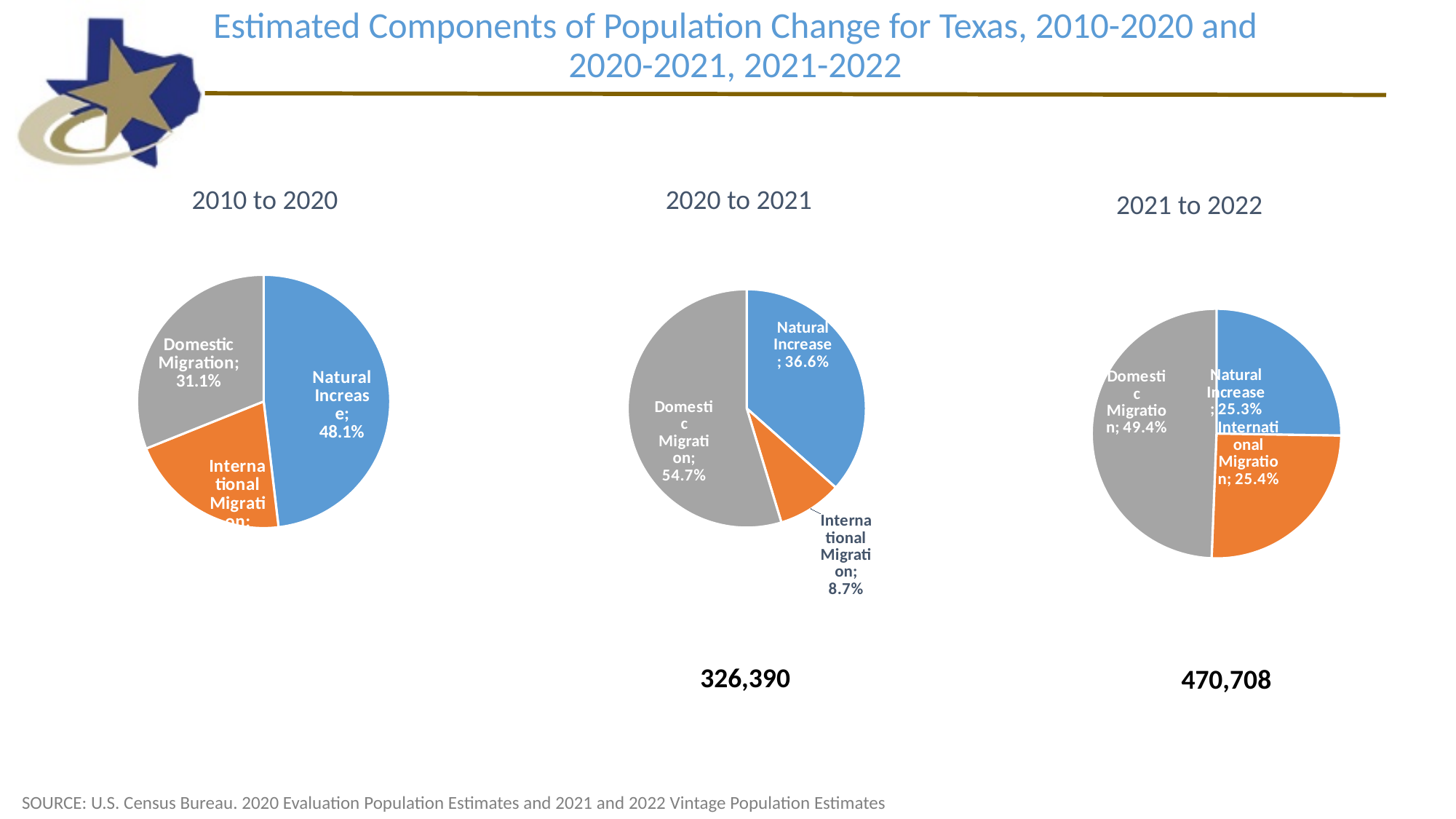
In the 2020 to 2021 pie chart, which component has the smallest share? International Migration In the 2021 to 2022 pie chart, which component has the largest share? Domestic Migration In the 2020 to 2021 pie chart, what share is Domestic Migration? 54.7% In the 2020 to 2021 pie chart, how many percentage points larger is Domestic Migration than Natural Increase? 18.1 percentage points In the 2010 to 2020 pie chart, what share is Domestic Migration? 31.1% What total figure is printed below the 2021 to 2022 pie chart? 470,708 How many slices does the 2021 to 2022 pie chart have? 3 What type of chart is used for the 2020 to 2021 data? Pie chart In the 2010 to 2020 pie chart, what share is Natural Increase? 48.1% In the 2020 to 2021 pie chart, what share is International Migration? 8.7% In the 2010 to 2020 pie chart, which is larger, Natural Increase or Domestic Migration? Natural Increase In the 2021 to 2022 pie chart, what share is Natural Increase? 25.3%